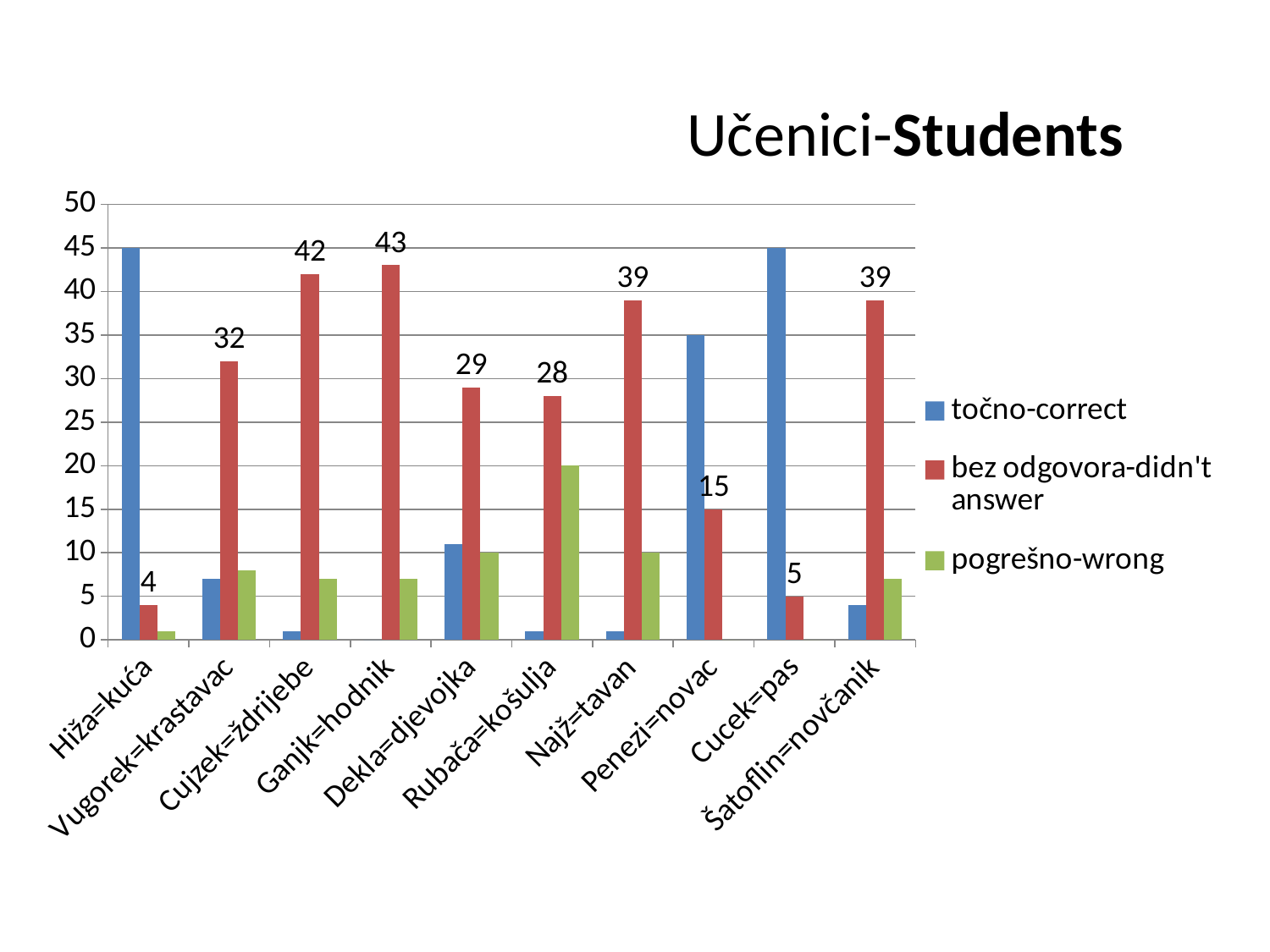
What is the value of the 'bez odgovora-didn't answer' series for Ganjk=hodnik? 43 What is the value of the 'bez odgovora-didn't answer' series for Hiža=kuća? 4 Which category has the highest 'bez odgovora-didn't answer' value? Ganjk=hodnik What is the title of the slide? Učenici-Students How many categories are shown on the x axis? 10 Which category has the lowest 'bez odgovora-didn't answer' value? Hiža=kuća Is the 'pogrešno-wrong' value for Rubača=košulja greater or less than 15? greater Which has a larger 'bez odgovora-didn't answer' value, Penezi=novac or Cucek=pas? Penezi=novac How many series does the legend list? 3 Is the 'točno-correct' value for Penezi=novac greater or less than 30? greater What kind of chart is shown on the slide? bar chart What is the difference between the 'bez odgovora-didn't answer' values for Cujzek=ždrijebe and Vugorek=krastavac? 10